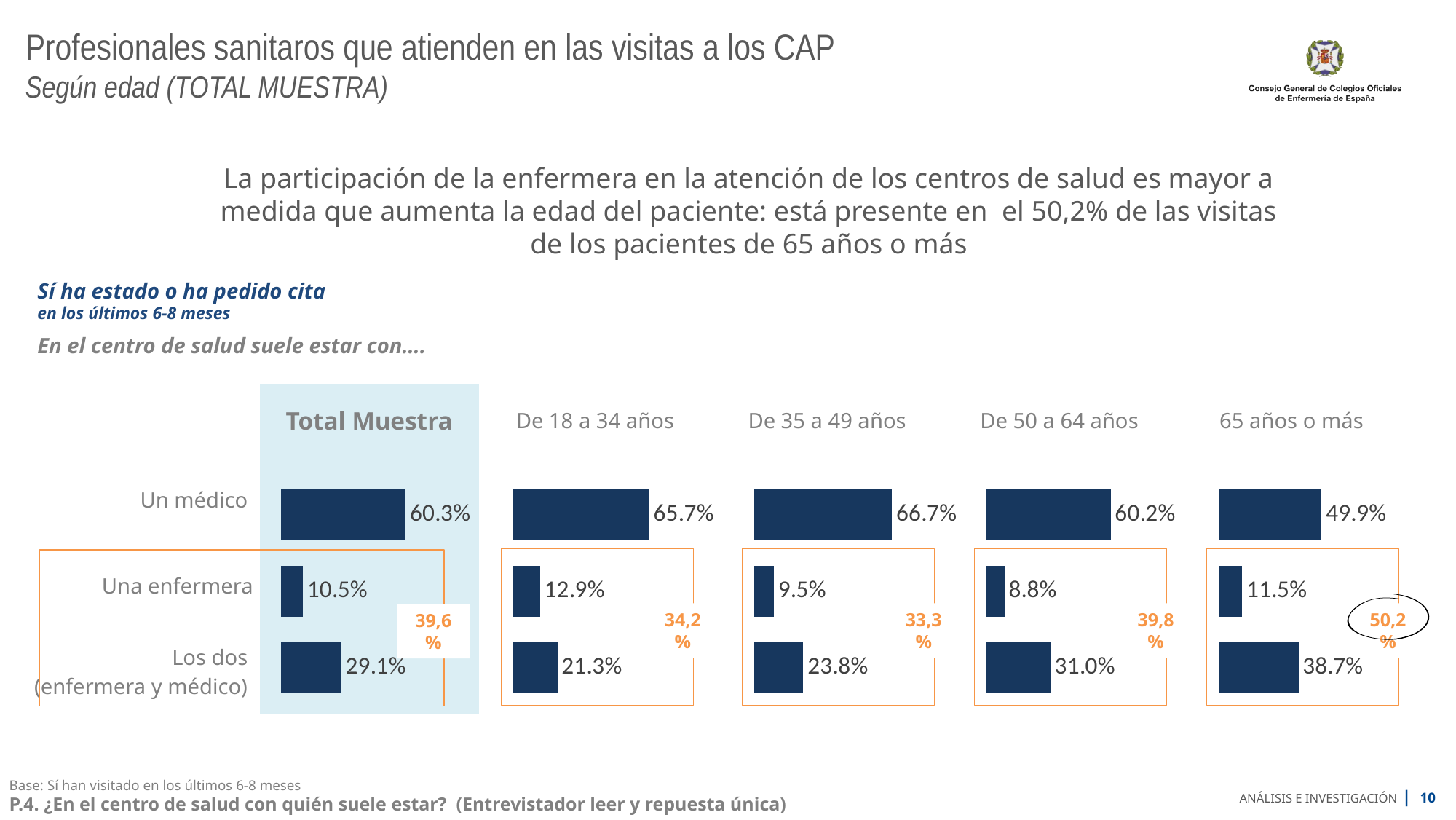
Which is larger: 'Un médico' in the 'De 18 a 34 años' chart or 'Un médico' in the 'De 35 a 49 años' chart? De 35 a 49 años What type of chart is used for the 'Total Muestra' data? Bar chart In the 'De 35 a 49 años' chart, which category has the highest value? Un médico In the 'De 50 a 64 años' chart, which category has the lowest value? Una enfermera In the 'Total Muestra' chart, what is the difference between 'Los dos (enfermera y médico)' and 'Una enfermera'? 18.6% What is the orange highlighted percentage shown for the '65 años o más' chart? 50,2% In the 'Total Muestra' chart, what is the value for 'Un médico'? 60.3% In the '65 años o más' chart, what is the difference between 'Un médico' and 'Los dos (enfermera y médico)'? 11.2% In the 'De 18 a 34 años' chart, what is the value for 'Una enfermera'? 12.9% How many categories does each of the bar charts on the slide show? 3 How many separate bar charts are shown on the slide? 5 In the '65 años o más' chart, what is the value for 'Los dos (enfermera y médico)'? 38.7%